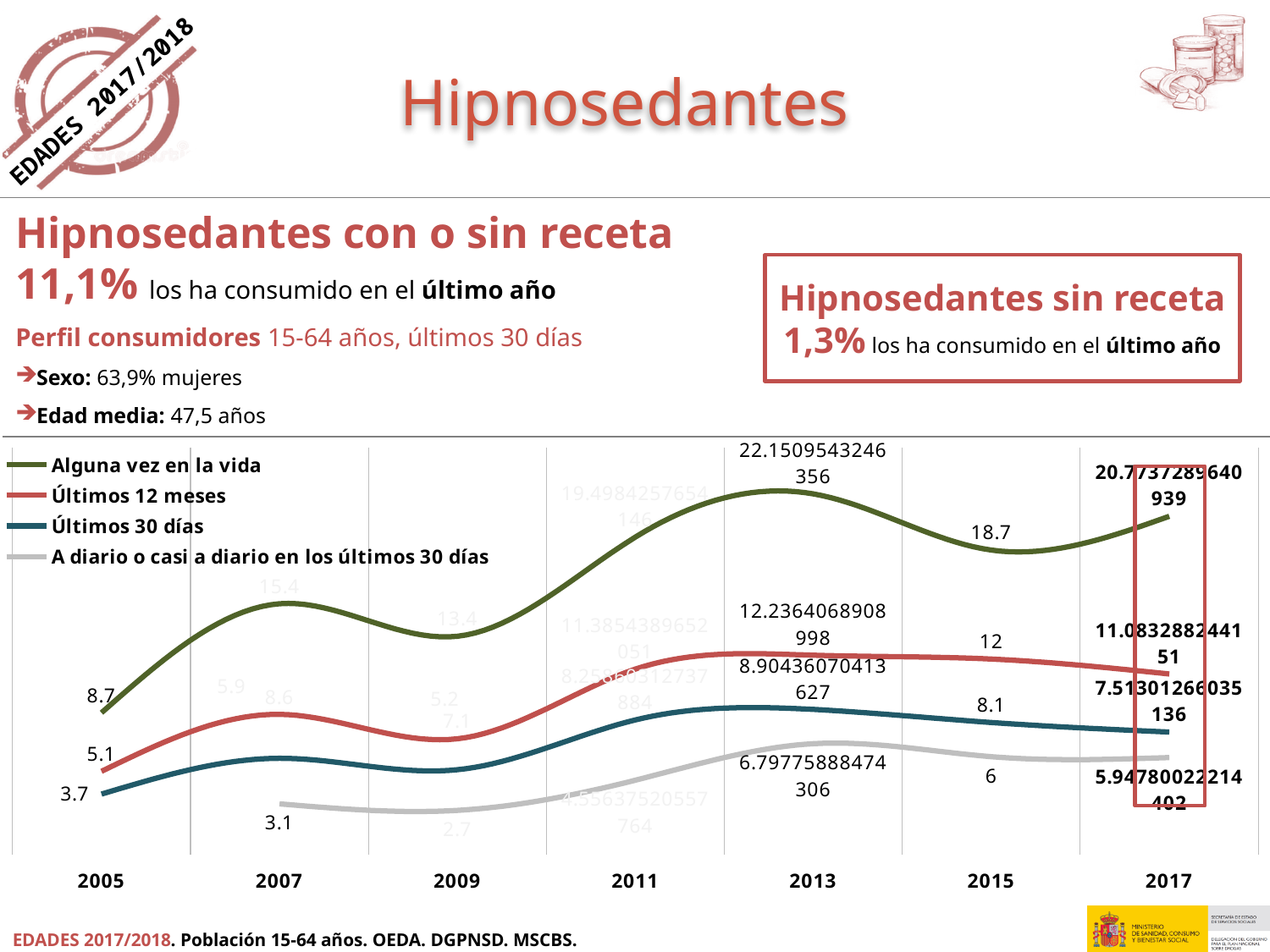
In which year does the 'Alguna vez en la vida' series reach its highest value? 2013 What is the value for 'Últimos 12 meses' in 2015? 12 Does the 'Alguna vez en la vida' series rise or fall from 2005 to 2007? rise What is the value for 'Alguna vez en la vida' in 2015? 18.7 What is the difference between 'Alguna vez en la vida' and 'Últimos 12 meses' in 2015? 6.7 How many years are shown on the x axis of the chart? 7 What is the value for 'Últimos 30 días' in 2005? 3.7 What colour is the line for 'Alguna vez en la vida'? green What kind of chart is shown on the slide? line chart What is the value for 'A diario o casi a diario en los últimos 30 días' in 2007? 3.1 How many series does the chart legend list? 4 In 2005, which is larger: 'Últimos 12 meses' or 'Últimos 30 días'? Últimos 12 meses